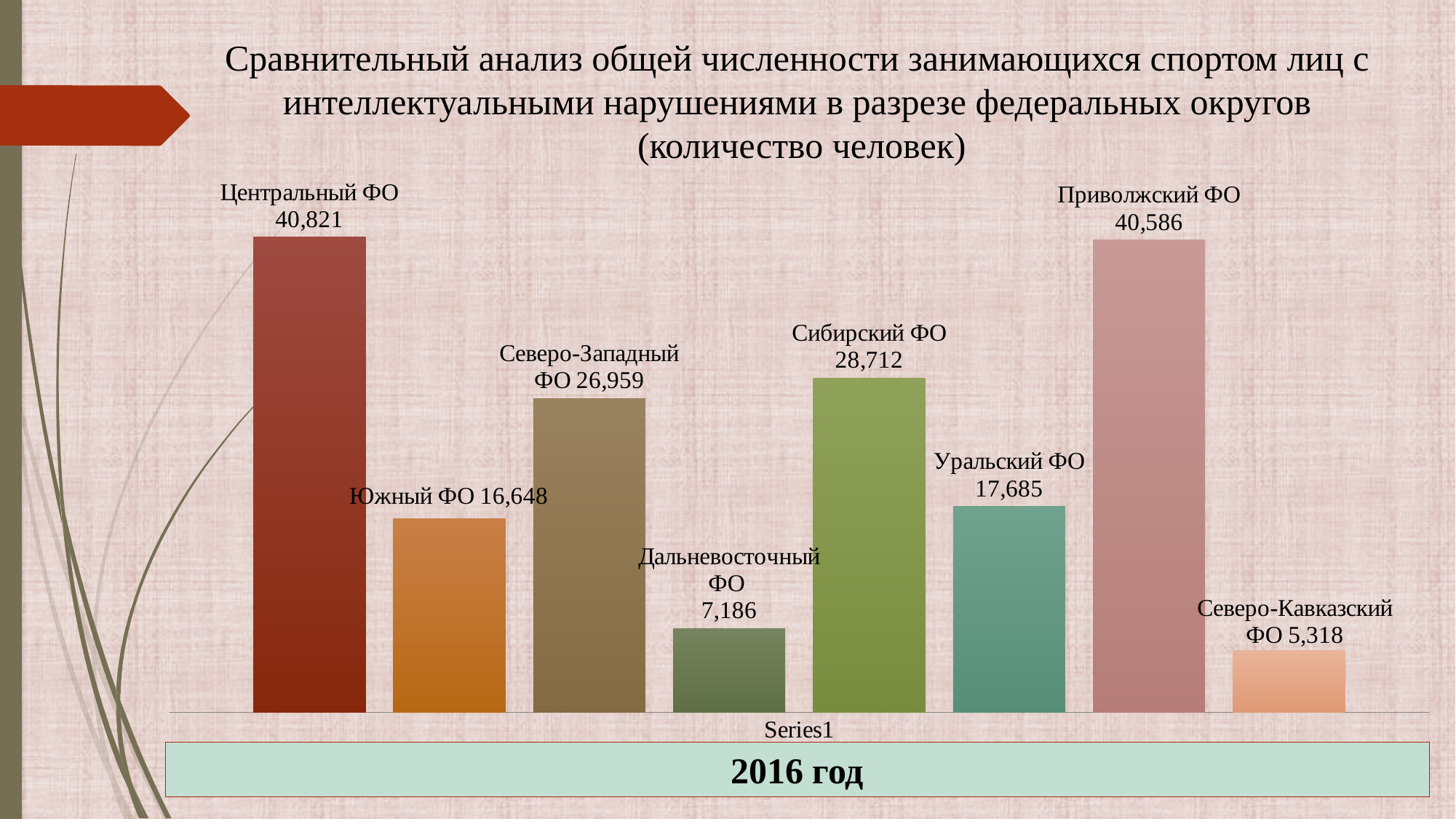
Which is larger, the value for Южный ФО or the value for Уральский ФО? Уральский ФО Which year does the chart refer to? 2016 год What is the difference between the values for Центральный ФО and Приволжский ФО? 235 What is the value for Уральский ФО? 17,685 What is the difference between the values for Сибирский ФО and Северо-Западный ФО? 1,753 Which federal district has the lowest value? Северо-Кавказский ФО What is the value for Северо-Кавказский ФО? 5,318 What is the value for Центральный ФО? 40,821 Which federal district has the highest value? Центральный ФО What is the value for Дальневосточный ФО? 7,186 How many federal districts are shown in the chart? 8 What kind of chart is shown on the slide? Bar chart